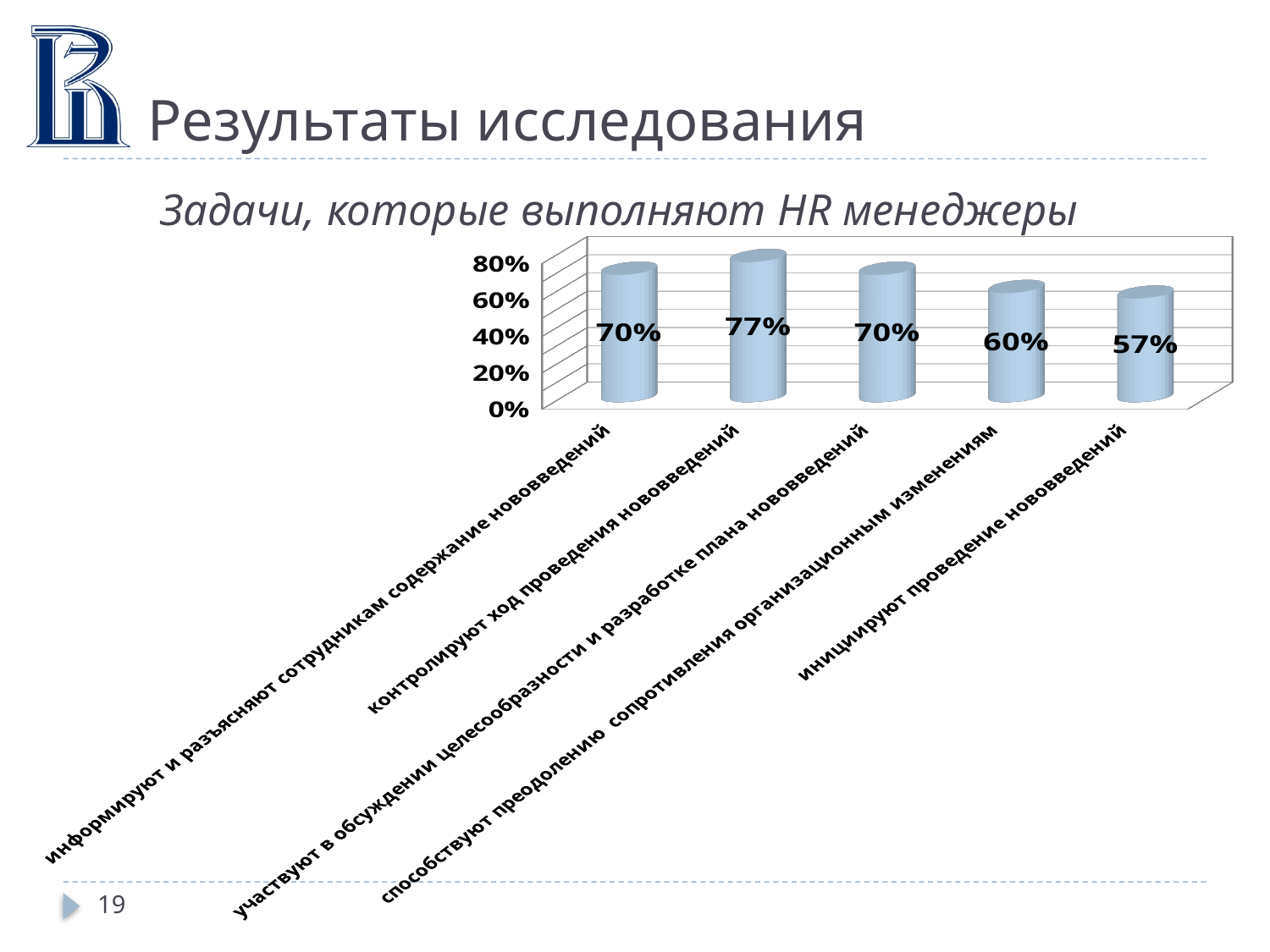
What kind of chart is shown on the slide? bar chart What value is shown for the category "информируют и разъясняют сотрудникам содержание нововведений"? 70% Which category has the lowest value? инициируют проведение нововведений Is the value for "инициируют проведение нововведений" greater or less than 60%? less Which category has the highest value? контролируют ход проведения нововведений What value is shown for the category "способствуют преодолению сопротивления организационным изменениям"? 60% What is the title of the chart? Задачи, которые выполняют HR менеджеры What value is shown for the category "инициируют проведение нововведений"? 57% Which is larger: the value for "способствуют преодолению сопротивления организационным изменениям" or the value for "участвуют в обсуждении целесообразности и разработке плана нововведений"? участвуют в обсуждении целесообразности и разработке плана нововведений How many categories are shown in the chart? 5 What value is shown for the category "контролируют ход проведения нововведений"? 77% What is the difference between the values for "контролируют ход проведения нововведений" and "инициируют проведение нововведений"? 20%